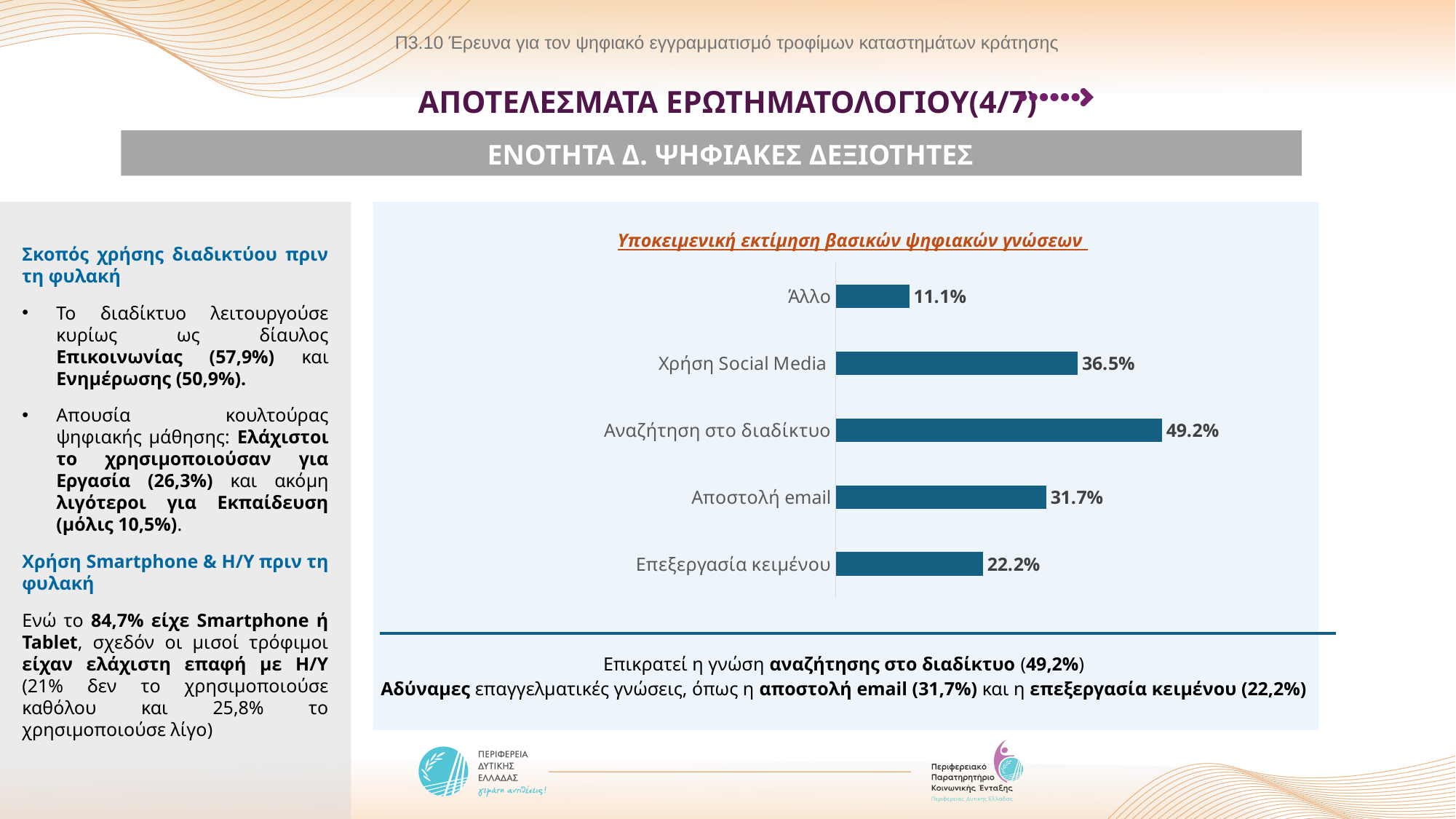
How many categories are shown in the chart? 5 What kind of chart is shown? Bar chart What is the value for Αποστολή email? 31.7% What is the value for Επεξεργασία κειμένου? 22.2% Which category has the highest value? Αναζήτηση στο διαδίκτυο What is the value for Αναζήτηση στο διαδίκτυο? 49.2% What is the difference between Αναζήτηση στο διαδίκτυο and Χρήση Social Media? 12.7% Which is larger, Αποστολή email or Επεξεργασία κειμένου? Αποστολή email What is the title of the chart? Υποκειμενική εκτίμηση βασικών ψηφιακών γνώσεων What is the value for Χρήση Social Media? 36.5% What is the value for Άλλο? 11.1% Which category has the lowest value? Άλλο